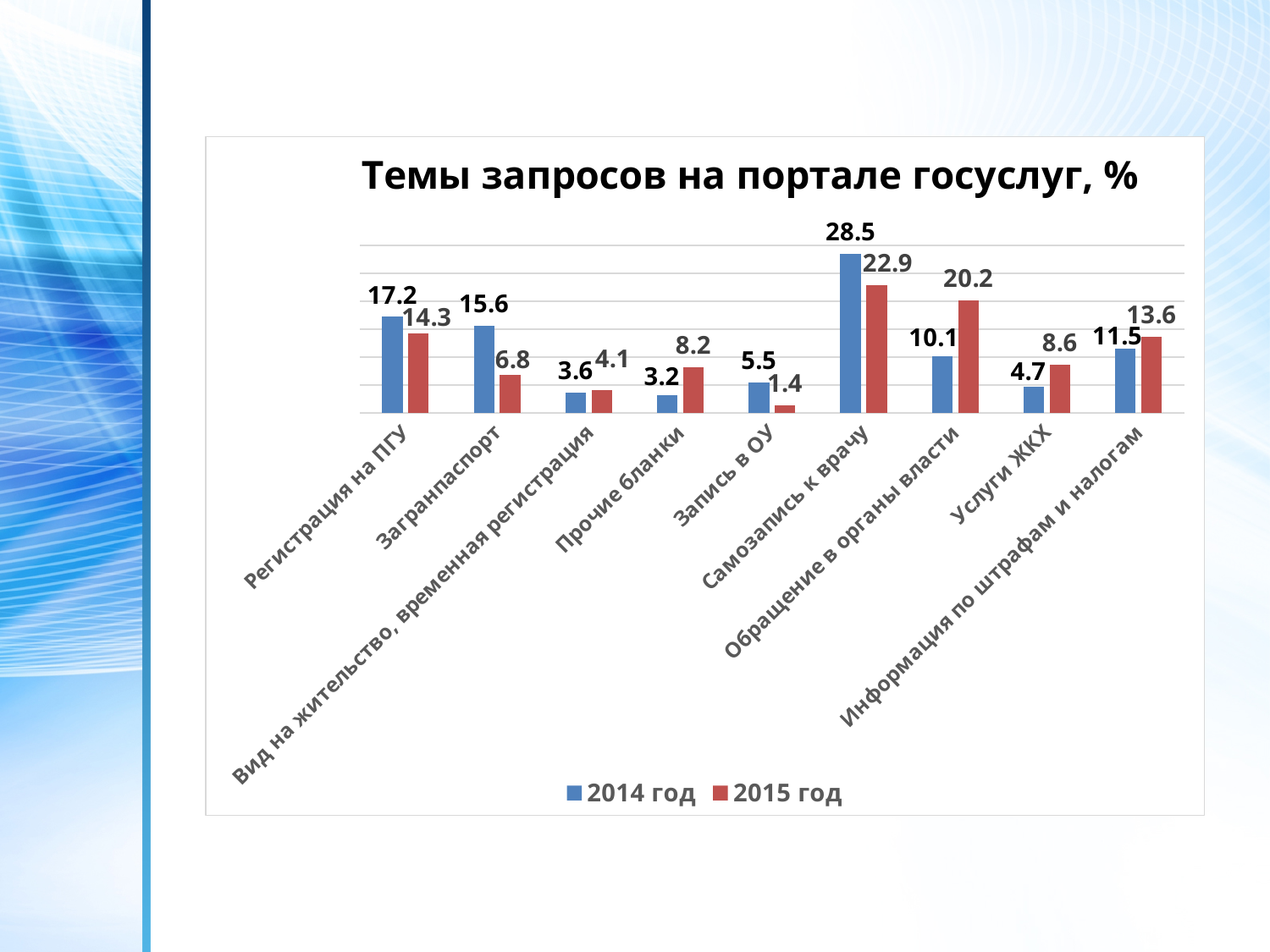
What is the value for Загранпаспорт in the 2015 год series? 6.8 What is the difference between the 2014 год and 2015 год values for Загранпаспорт? 8.8 How many categories are shown on the x axis? 9 What is the title of the chart? Темы запросов на портале госуслуг, % Which category has the highest value in the 2014 год series? Самозапись к врачу What is the value for Обращение в органы власти in the 2015 год series? 20.2 Which category has the lowest value in the 2015 год series? Запись в ОУ How many series does the legend list? 2 What kind of chart is shown on the slide? Bar chart What is the difference between the 2015 год and 2014 год values for Обращение в органы власти? 10.1 What is the value for Самозапись к врачу in the 2014 год series? 28.5 Which is larger for Прочие бланки: the 2014 год value or the 2015 год value? 2015 год